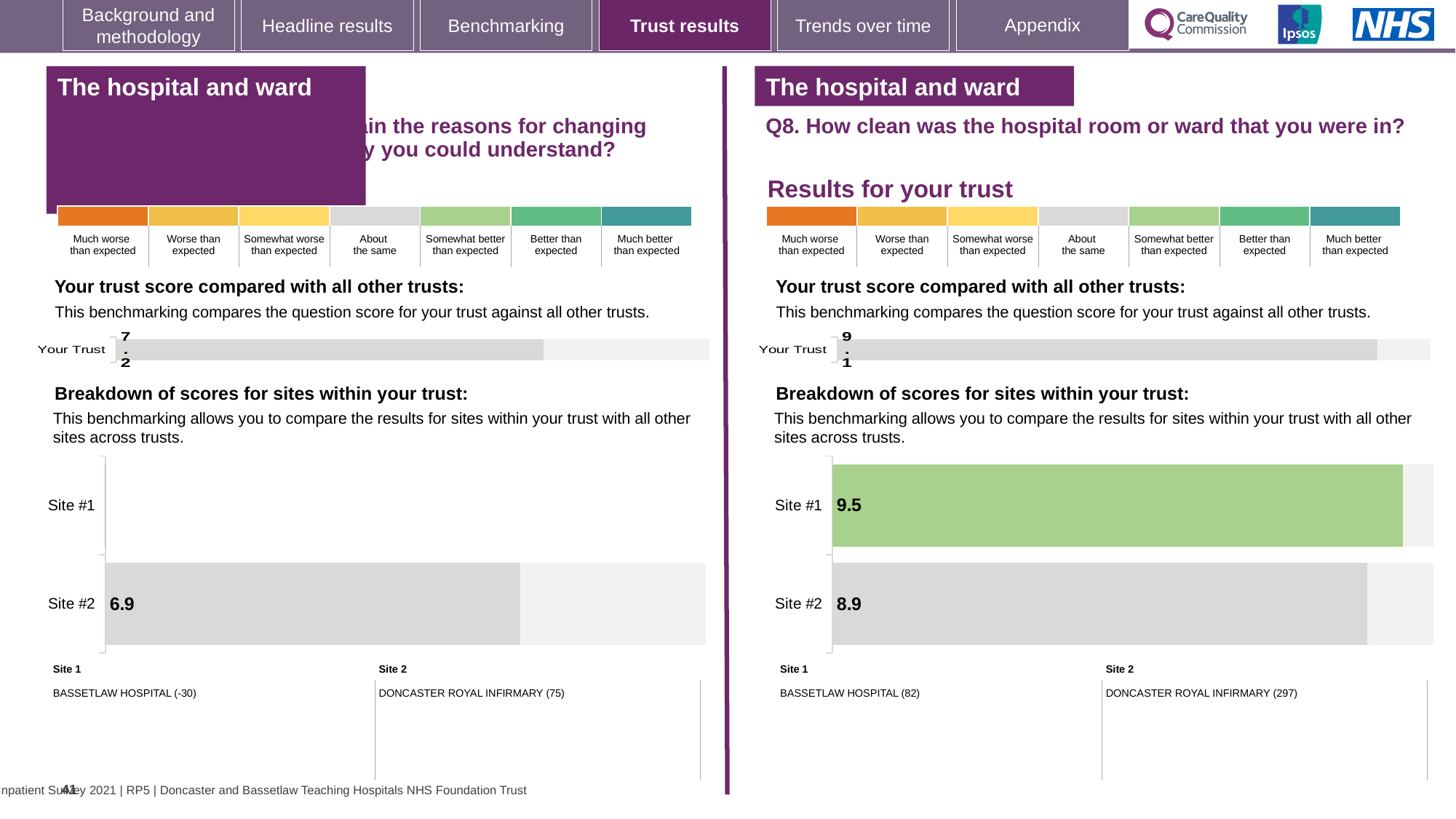
What type of chart is used to show the breakdown of scores for sites within your trust on the right-hand side? bar chart On the left-hand site breakdown chart, what is the score for Site #2? 6.9 On the right-hand Q8 site breakdown chart, which benchmark category colour is the Site #1 bar shaded in? Somewhat better than expected (light green) On the right-hand site breakdown chart for Q8, which site has the higher score? Site #1 On the right-hand 'Your trust score compared with all other trusts' chart for Q8, what is the score shown for Your Trust? 9.1 How many sites are listed in the right-hand site breakdown chart for Q8? 2 On the left-hand 'Your trust score compared with all other trusts' chart, what is the score shown for Your Trust? 7.2 On the right-hand chart for Q8 (how clean was the hospital room or ward), what is the score for Site #1? 9.5 Is the Site #2 score on the right-hand Q8 chart larger or smaller than the Site #2 score on the left-hand chart? larger On the right-hand site breakdown chart for Q8, which site has the lower score? Site #2 On the right-hand chart for Q8 (how clean was the hospital room or ward), what is the score for Site #2? 8.9 On the right-hand site breakdown chart for Q8, what is the difference between the Site #1 and Site #2 scores? 0.6